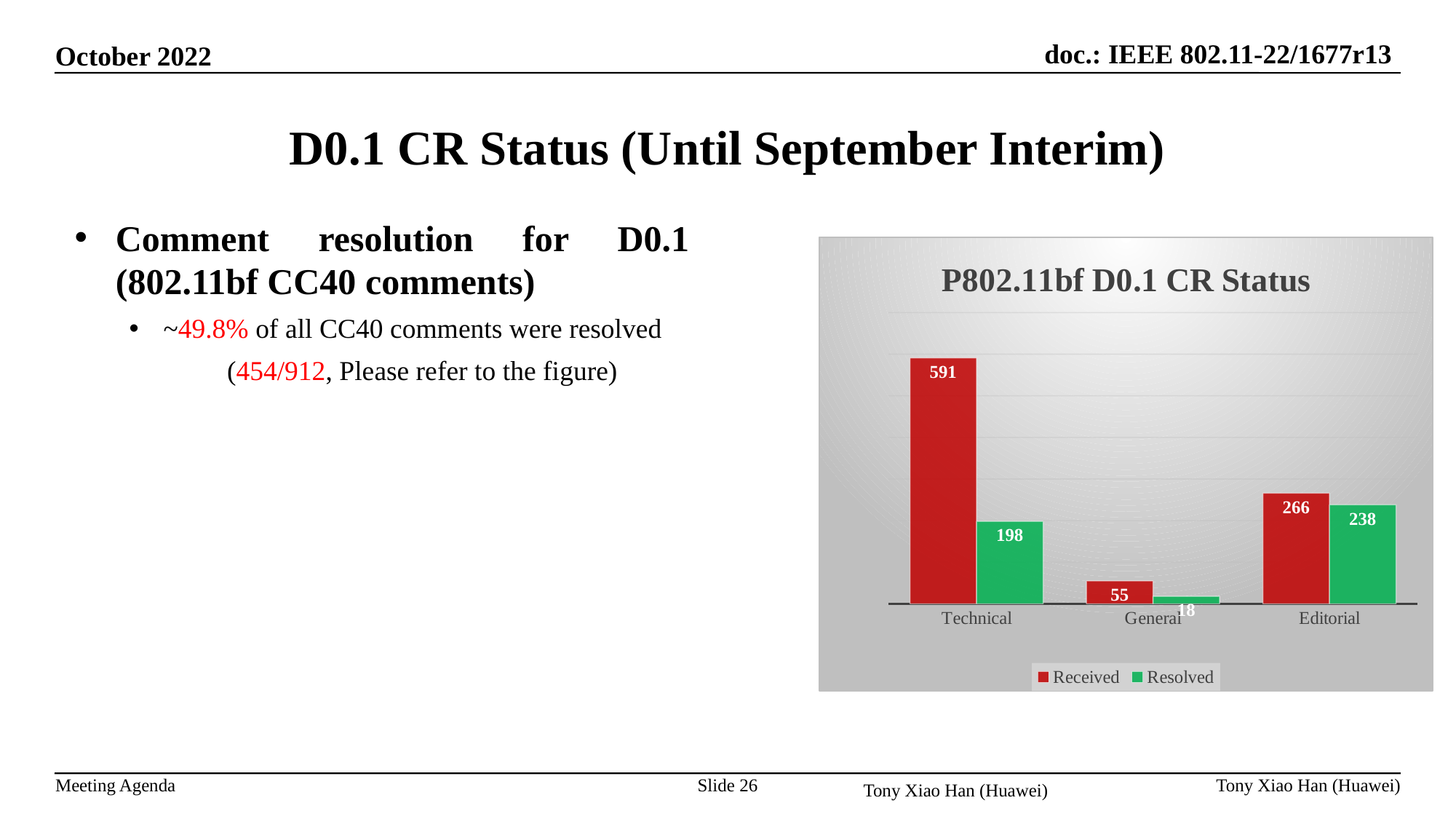
What is the difference between Received and Resolved for Editorial? 28 What is the difference between Received and Resolved for Technical? 393 What is the title of the chart? P802.11bf D0.1 CR Status Which category has the lowest Resolved value? General What is the Resolved value for Editorial? 238 Which is larger, the Received value for General or the Resolved value for Technical? Resolved value for Technical What is the Resolved value for General? 18 What kind of chart is shown? Bar chart How many series does the legend list? 2 Which category has the highest Received value? Technical What is the Received value for Technical? 591 How many categories are shown on the x axis? 3